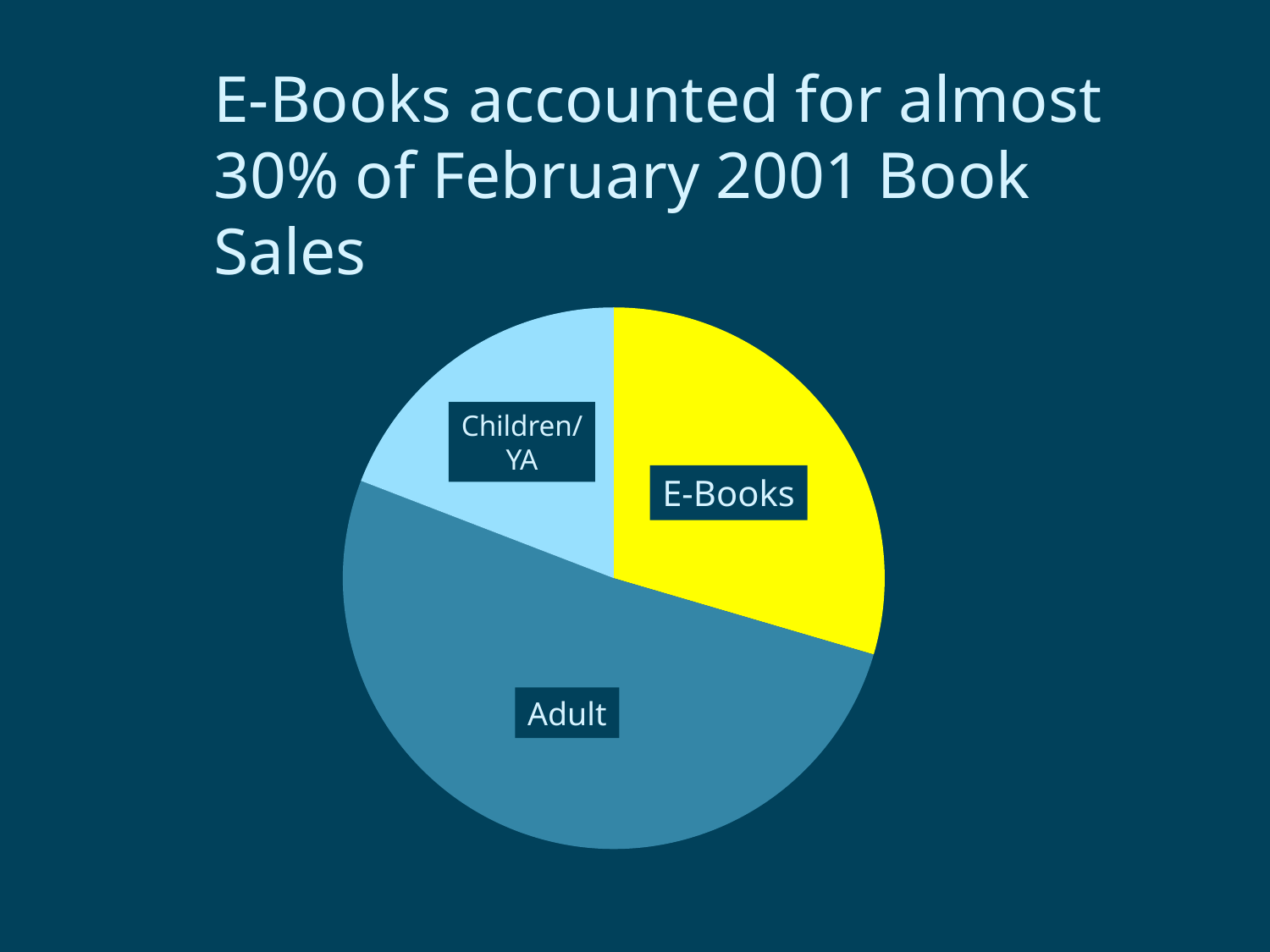
How many slices does the pie chart have? 3 What colour is the E-Books slice of the pie chart? yellow Which category has the largest slice of the pie chart? Adult Which slice is larger, Adult or E-Books? Adult Which slice is smaller, Adult or Children/YA? Children/YA What kind of chart is shown on the slide? pie chart Which category has the smallest slice of the pie chart? Children/YA What is the title of the slide containing the pie chart? E-Books accounted for almost 30% of February 2001 Book Sales Which slice is larger, E-Books or Children/YA? E-Books